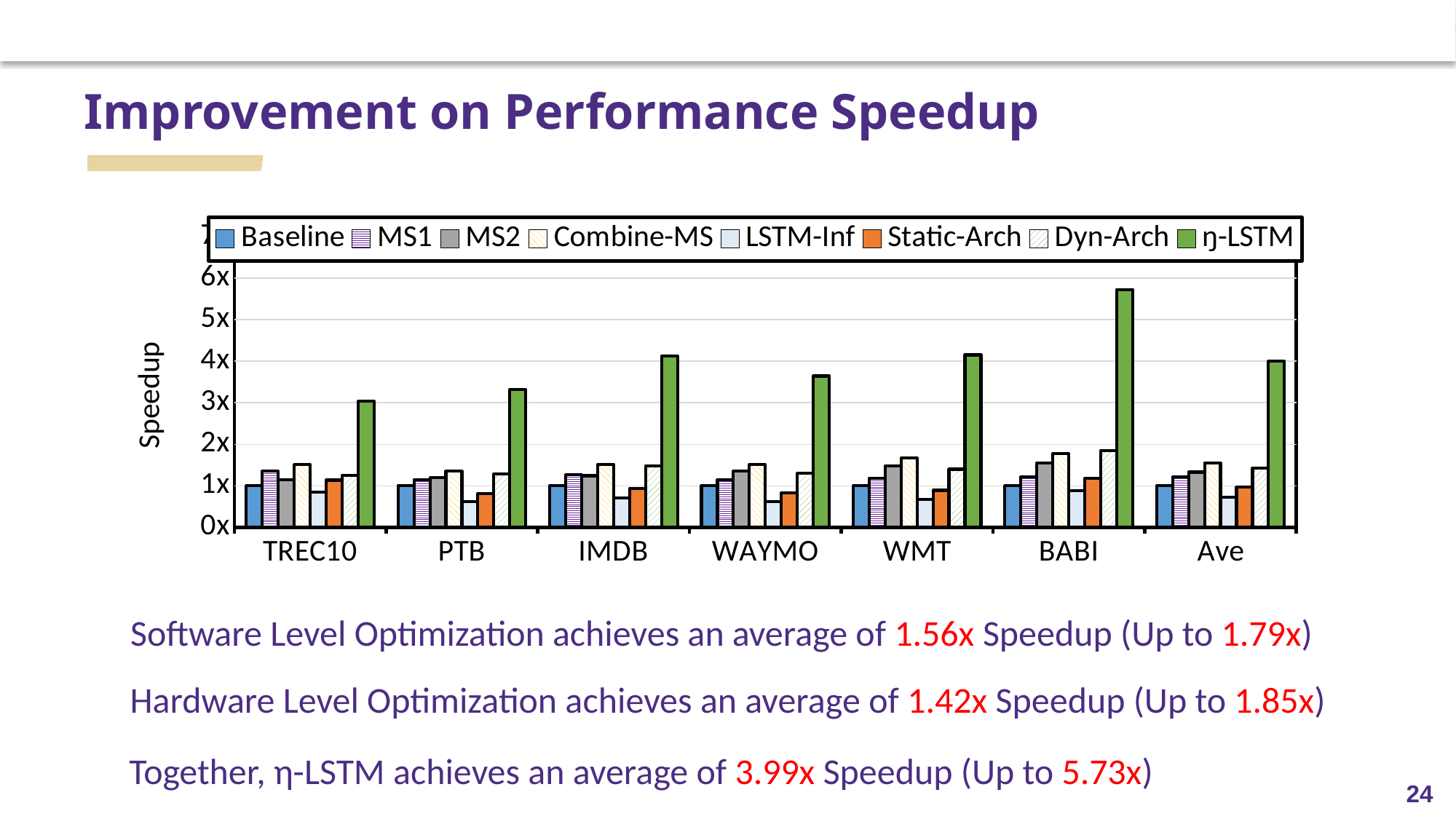
Which series has the highest speedup in every category? η-LSTM Is the η-LSTM speedup for BABI greater or less than 5x? greater Which is larger, the η-LSTM speedup for BABI or for TREC10? BABI Is the LSTM-Inf speedup for PTB greater or less than 1x? less How many series does the legend list? 8 Is the η-LSTM speedup for WAYMO greater or less than 4x? less What is the Baseline speedup for TREC10? 1x Which category has the highest η-LSTM speedup? BABI Which series has the lowest speedup for TREC10? LSTM-Inf What kind of chart is shown on the slide? bar chart How many categories are shown along the x axis? 7 What is the label on the y axis? Speedup